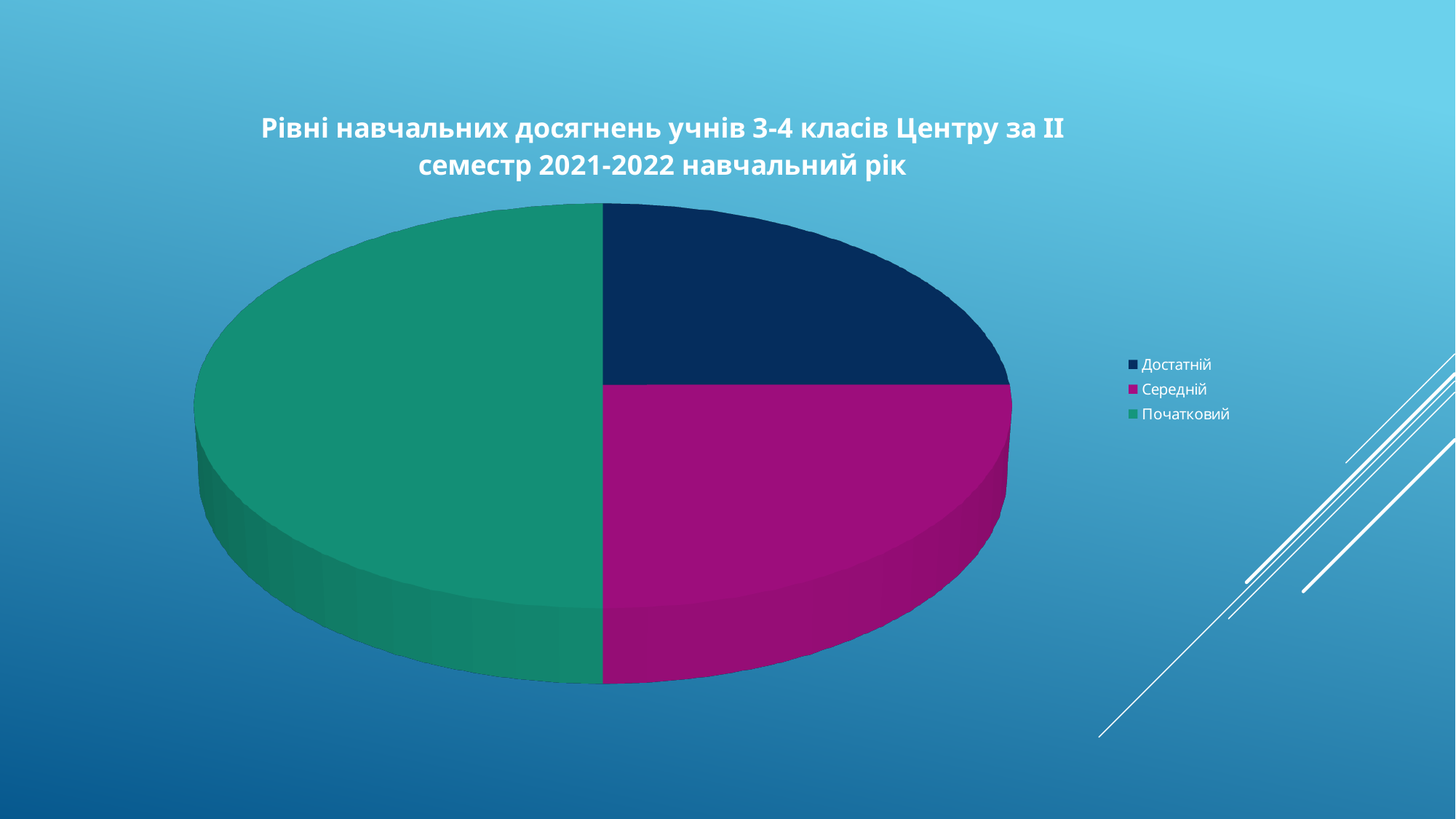
Which category is shown in green in the pie chart? Початковий Which category has the largest slice of the pie? Початковий Which slice is larger, Початковий or Достатній? Початковий How many entries does the legend list? 3 What kind of chart is shown on the slide? pie chart How many slices does the pie chart have? 3 What is the title of the chart? Рівні навчальних досягнень учнів 3-4 класів Центру за ІІ семестр 2021-2022 навчальний рік Which slice is larger, Початковий or Середній? Початковий